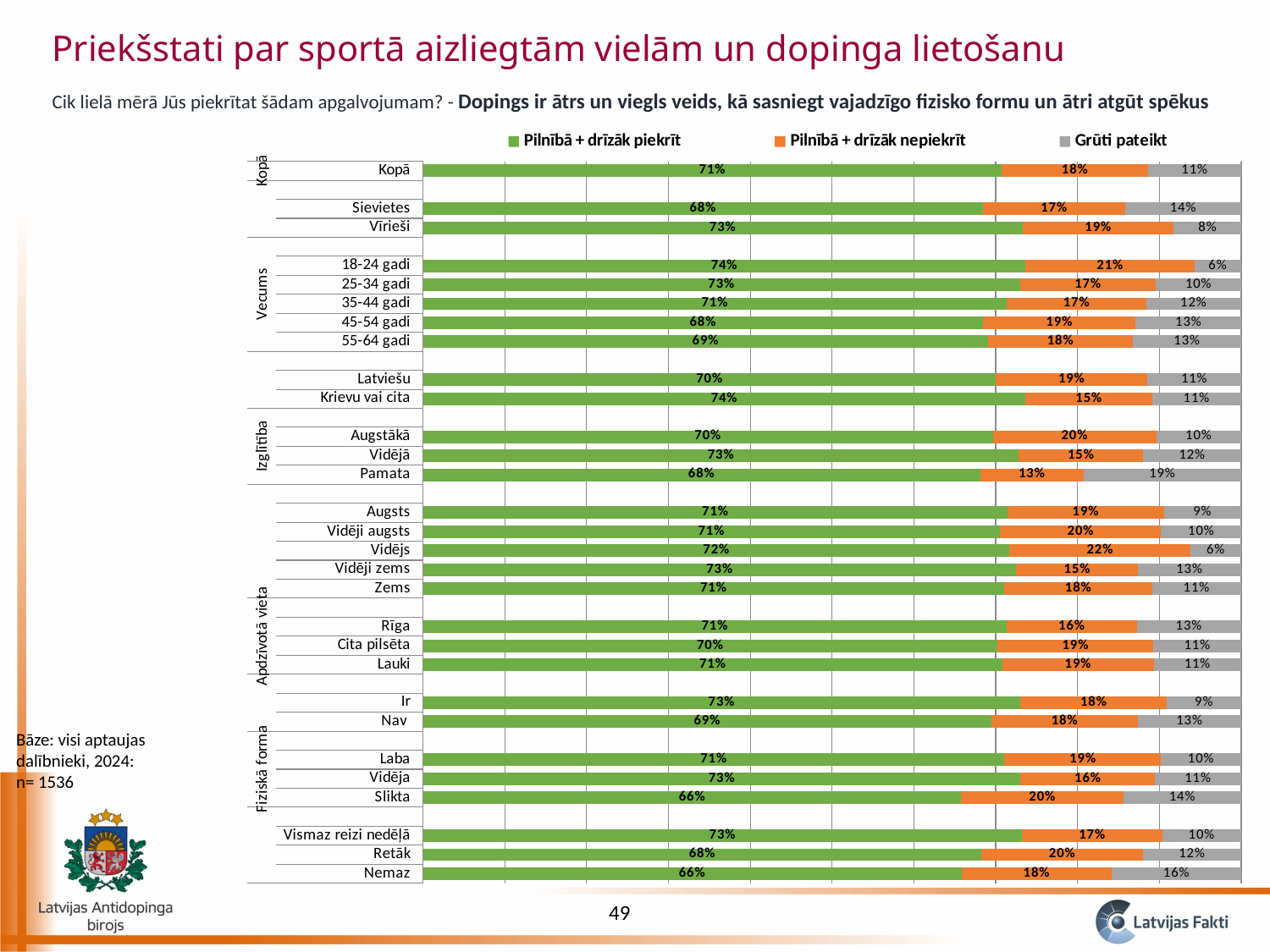
Which category has the highest value for "Pilnībā + drīzāk nepiekrīt"? Vidējs Which category has the highest value for "Grūti pateikt"? Pamata What is the total of the three segments for the Nemaz bar? 100% Which has a larger "Pilnībā + drīzāk piekrīt" value, Slikta or Laba? Laba Which category has the lowest value for "Pilnībā + drīzāk nepiekrīt"? Pamata What is the value of "Grūti pateikt" for Sievietes? 14% How many series does the legend list? 3 What type of chart is shown on the slide? stacked bar chart What is the difference between the "Pilnībā + drīzāk piekrīt" values for Vīrieši and Sievietes? 5% What is the value of "Pilnībā + drīzāk piekrīt" for Vismaz reizi nedēļā? 73% What is the value of "Pilnībā + drīzāk nepiekrīt" for 18-24 gadi? 21% What is the value of "Pilnībā + drīzāk piekrīt" for Kopā? 71%